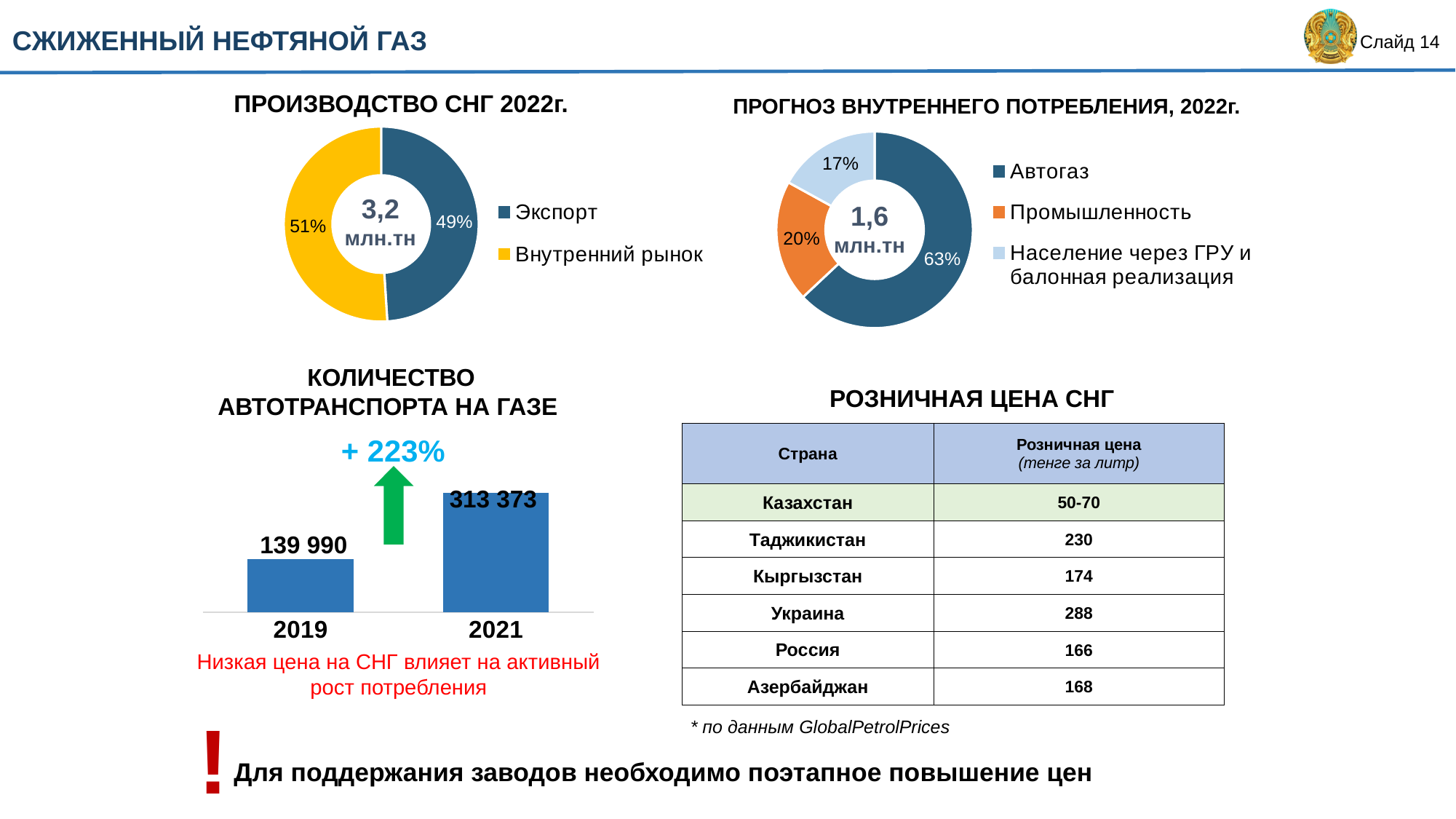
What kind of chart is the one titled "КОЛИЧЕСТВО АВТОТРАНСПОРТА НА ГАЗЕ"? Bar chart In the chart titled "КОЛИЧЕСТВО АВТОТРАНСПОРТА НА ГАЗЕ", what is the difference between the 2021 and 2019 values? 173 383 In the chart titled "ПРОГНОЗ ВНУТРЕННЕГО ПОТРЕБЛЕНИЯ, 2022г.", what share is labelled for Промышленность? 20% In the chart titled "КОЛИЧЕСТВО АВТОТРАНСПОРТА НА ГАЗЕ", what is the value for 2021? 313 373 In the chart titled "ПРОГНОЗ ВНУТРЕННЕГО ПОТРЕБЛЕНИЯ, 2022г.", how many slices does the donut have? 3 In the chart titled "ПРОГНОЗ ВНУТРЕННЕГО ПОТРЕБЛЕНИЯ, 2022г.", what share is labelled for Автогаз? 63% In the chart titled "ПРОИЗВОДСТВО СНГ 2022г.", how many entries does the legend list? 2 In the chart titled "ПРОГНОЗ ВНУТРЕННЕГО ПОТРЕБЛЕНИЯ, 2022г.", which category has the smallest share? Население через ГРУ и балонная реализация In the chart titled "ПРОИЗВОДСТВО СНГ 2022г.", what share is labelled for Внутренний рынок? 51% In the chart titled "ПРОИЗВОДСТВО СНГ 2022г.", what share is labelled for Экспорт? 49% In the chart titled "ПРОГНОЗ ВНУТРЕННЕГО ПОТРЕБЛЕНИЯ, 2022г.", what is the difference in percentage points between Автогаз and Промышленность? 43 In the chart titled "ПРОИЗВОДСТВО СНГ 2022г.", what value is shown in the centre of the donut? 3,2 млн.тн